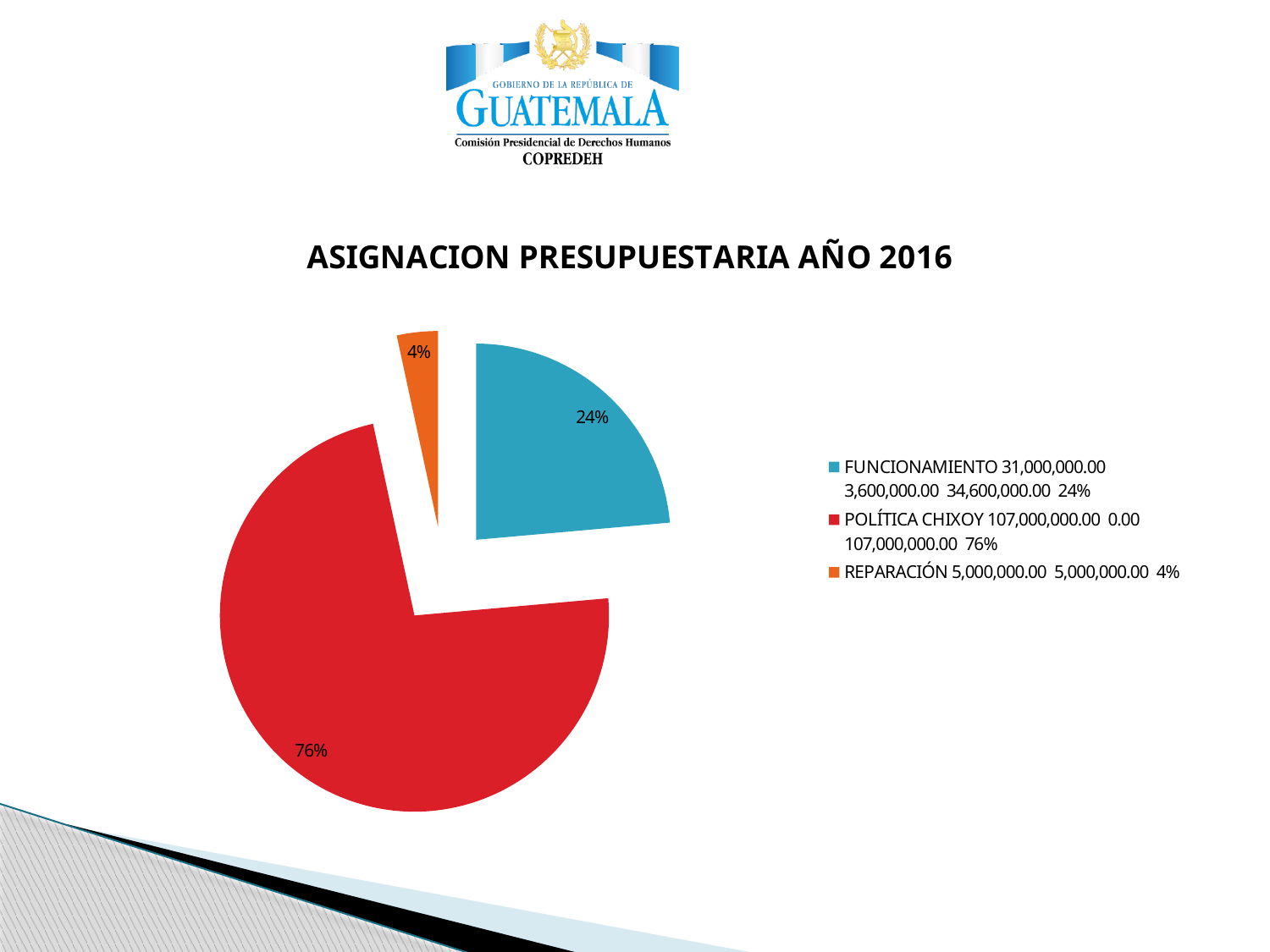
What percentage share does the REPARACIÓN slice represent? 4% How many slices does the pie chart have? 3 Which category has the smallest slice of the pie? REPARACIÓN Which slice is larger, FUNCIONAMIENTO or REPARACIÓN? FUNCIONAMIENTO Which category has the largest slice of the pie? POLÍTICA CHIXOY What colour is the POLÍTICA CHIXOY slice? Red What is the title of the chart? ASIGNACION PRESUPUESTARIA AÑO 2016 What is the difference in percentage points between the POLÍTICA CHIXOY slice and the FUNCIONAMIENTO slice? 52 percentage points What kind of chart is shown on the slide? Pie chart How many entries does the legend list? 3 What percentage share does the POLÍTICA CHIXOY slice represent? 76% What percentage share does the FUNCIONAMIENTO slice represent? 24%